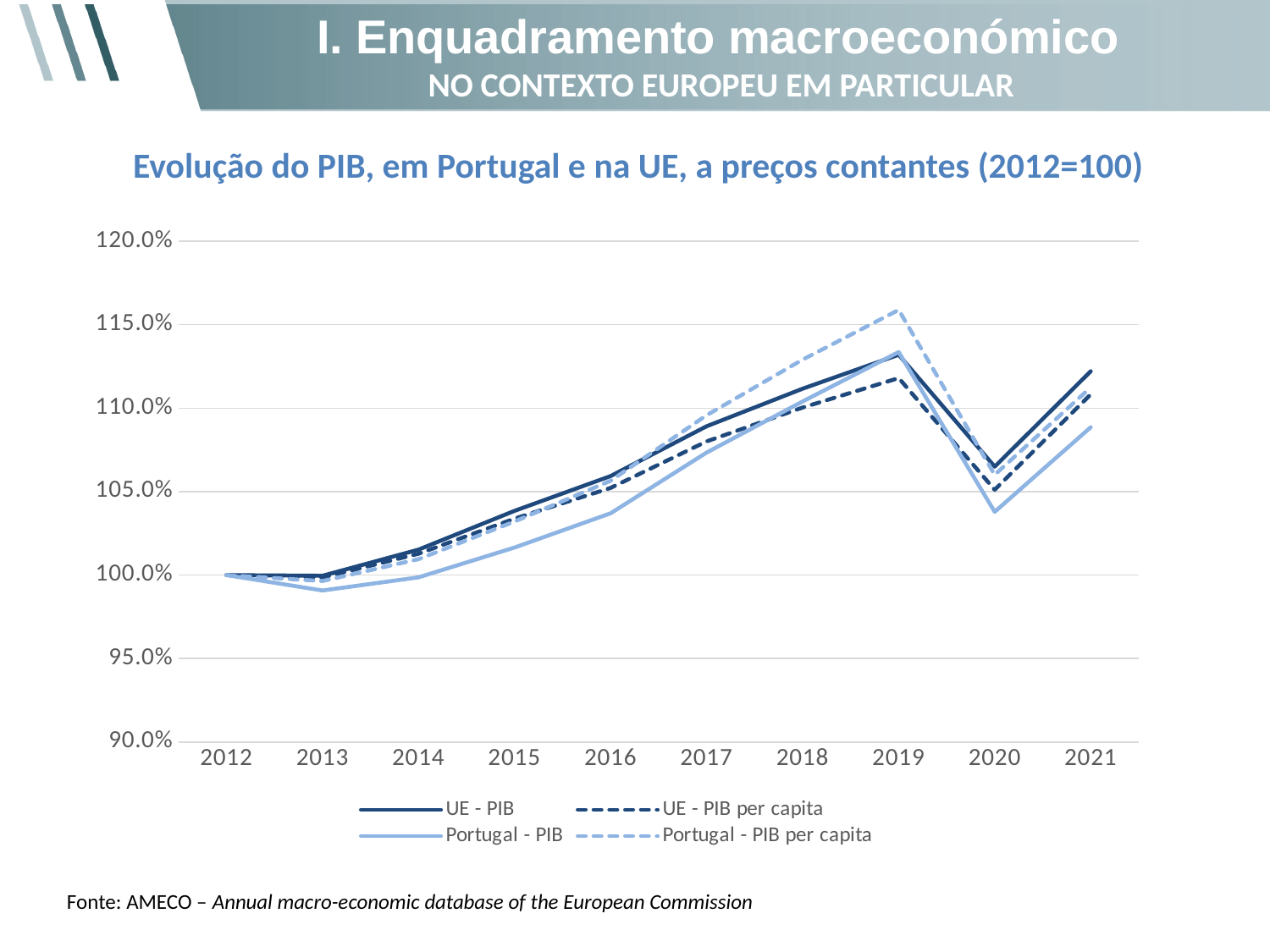
In which year does Portugal - PIB reach its lowest value? 2013 Is the value for UE - PIB in 2021 greater or less than 110.0%? greater What is the value of Portugal - PIB per capita in 2012? 100.0% How many series does the legend list? 4 Is the value for Portugal - PIB per capita in 2019 greater or less than 115.0%? greater What is the value of UE - PIB in 2012? 100.0% What kind of chart is shown on the slide? line chart In which year does Portugal - PIB per capita reach its highest value? 2019 How many years are shown on the x axis? 10 Do the series rise or fall between 2019 and 2020? fall In 2020, which is higher: UE - PIB or Portugal - PIB? UE - PIB Is the value for Portugal - PIB in 2020 greater or less than 105.0%? less